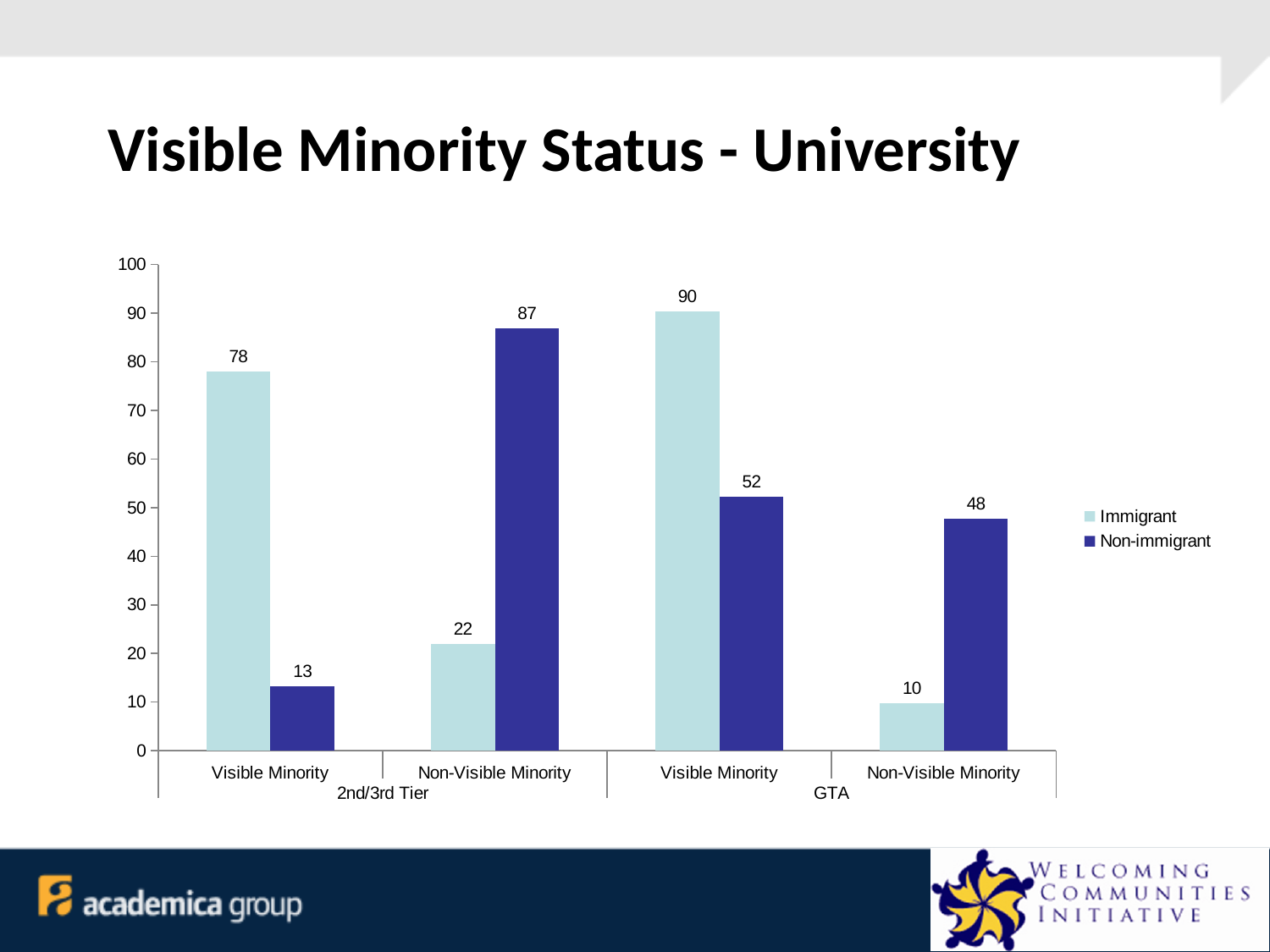
What is the Immigrant value for Non-Visible Minority in the 2nd/3rd Tier group? 22 What is the title of the chart? Visible Minority Status - University Which category has the highest Immigrant value? Visible Minority (GTA) What is the Immigrant value for Visible Minority in the 2nd/3rd Tier group? 78 Is the Non-immigrant value for Visible Minority in the GTA group greater or less than 60? less Which category has the lowest Non-immigrant value? Visible Minority (2nd/3rd Tier) What kind of chart is shown on the slide? Bar chart What is the difference between the Immigrant and Non-immigrant values for Visible Minority in the GTA group? 38 How many series does the legend list? 2 Which is larger for Non-Visible Minority in the 2nd/3rd Tier group: the Immigrant value or the Non-immigrant value? Non-immigrant How many categories are shown on the x axis? 4 What is the Non-immigrant value for Non-Visible Minority in the GTA group? 48